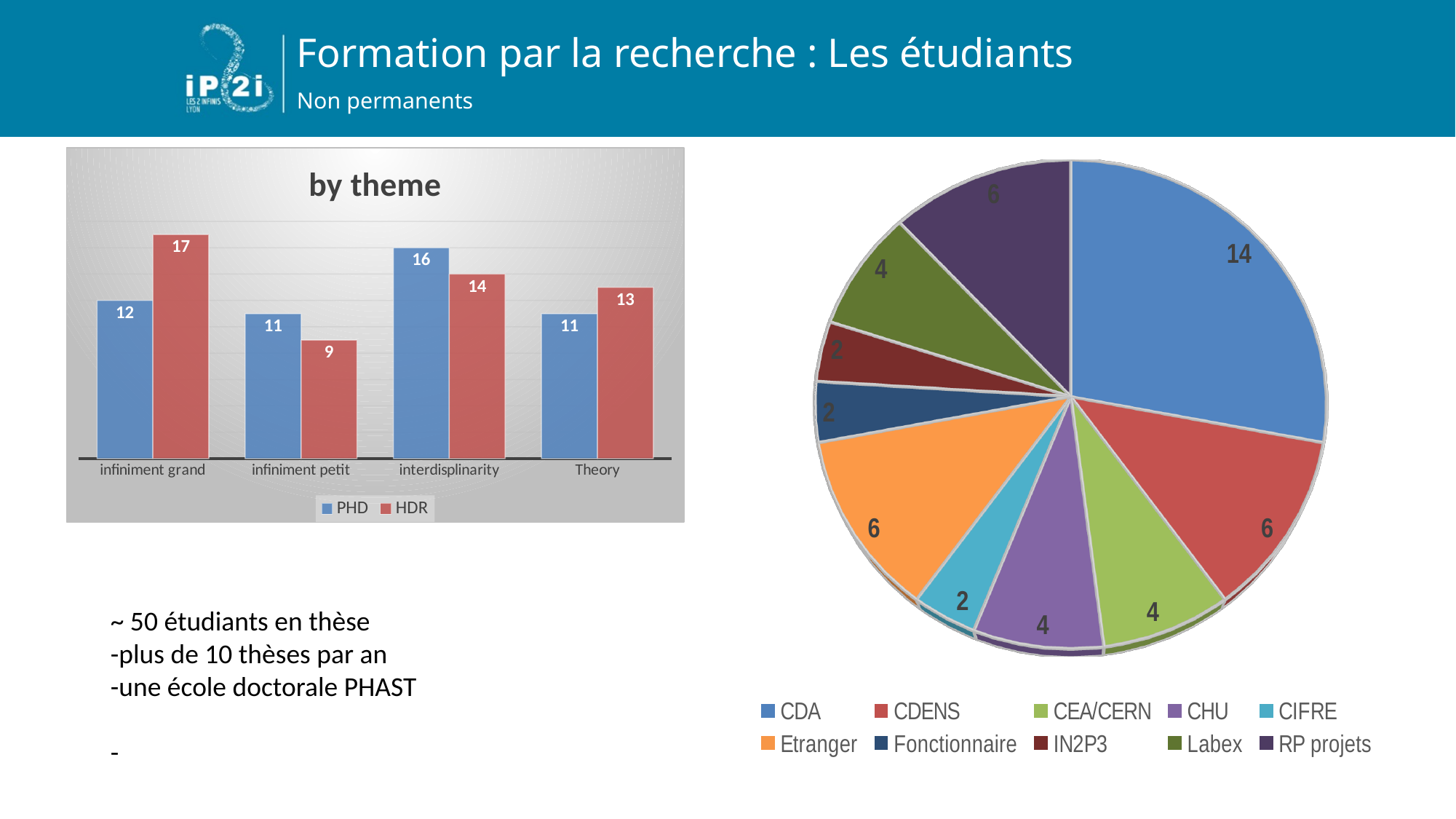
In the 'by theme' bar chart, which category has the highest PHD value? interdisplinarity In the pie chart on the right, which category has the largest slice? CDA What kind of chart is the 'by theme' chart on the left? bar chart In the 'by theme' bar chart, is the PHD or HDR value larger for Theory? HDR In the pie chart on the right, what share of the total does CDA represent? 28% In the 'by theme' bar chart, what is the PHD value for interdisplinarity? 16 In the 'by theme' bar chart, what is the HDR value for infiniment grand? 17 How many series does the legend of the 'by theme' bar chart list? 2 In the 'by theme' bar chart, what is the difference between the HDR and PHD values for infiniment grand? 5 In the 'by theme' bar chart, which category has the lowest HDR value? infiniment petit How many slices does the pie chart on the right have? 10 In the pie chart on the right, what is the value for CDA? 14